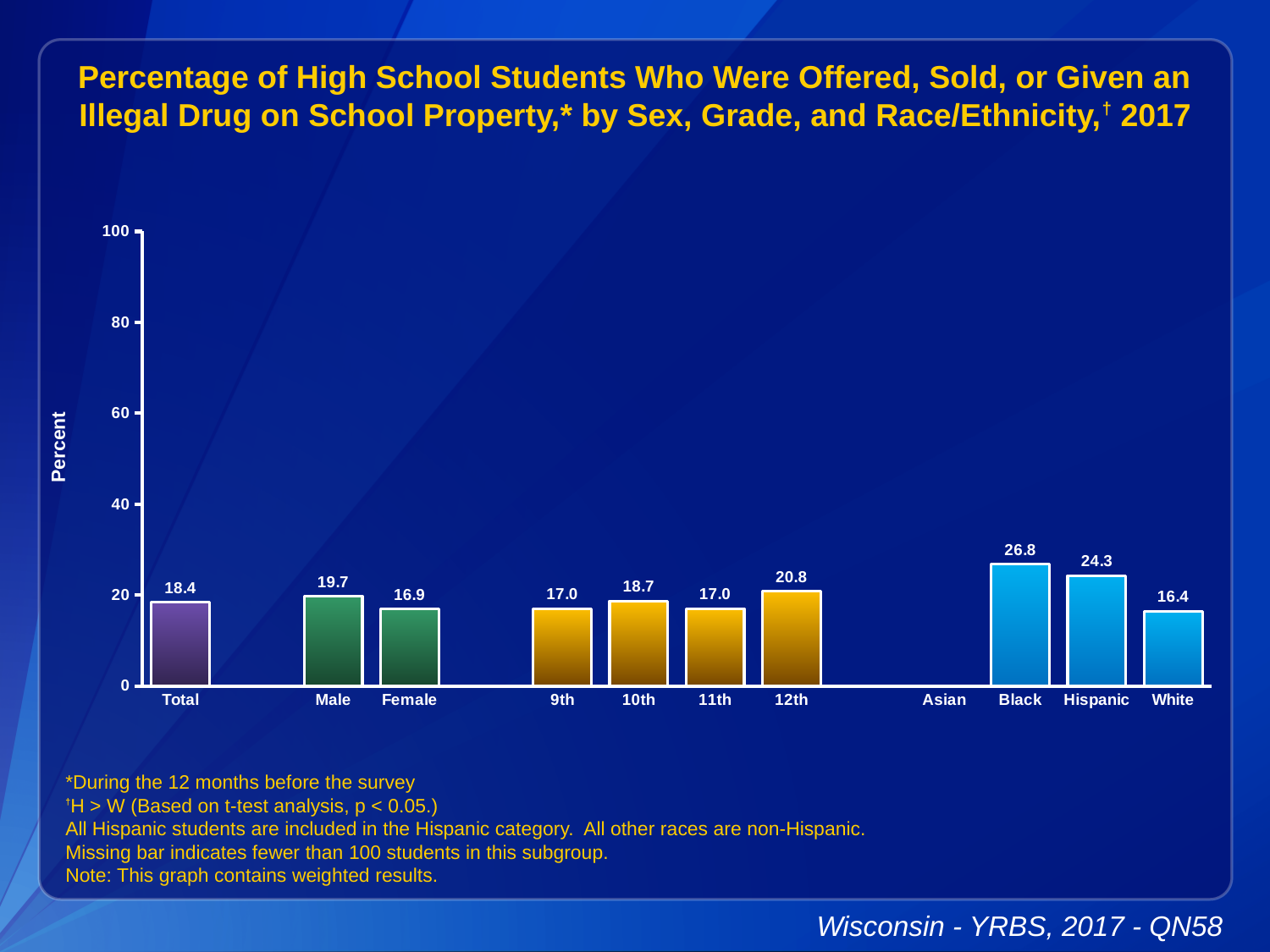
What is the value for 12th grade? 20.8 How many categories have a bar plotted? 11 Which race/ethnicity category has the lowest value? White What is the value for Hispanic students? 24.3 What kind of chart is shown? bar chart What is the value for Male? 19.7 Which is larger, the value for 10th grade or the value for 11th grade? 10th Which category has the highest value? Black Which category has no bar shown? Asian Is the value for Black students greater or less than 20? greater What is the value for Total? 18.4 What is the difference between the Male and Female values? 2.8